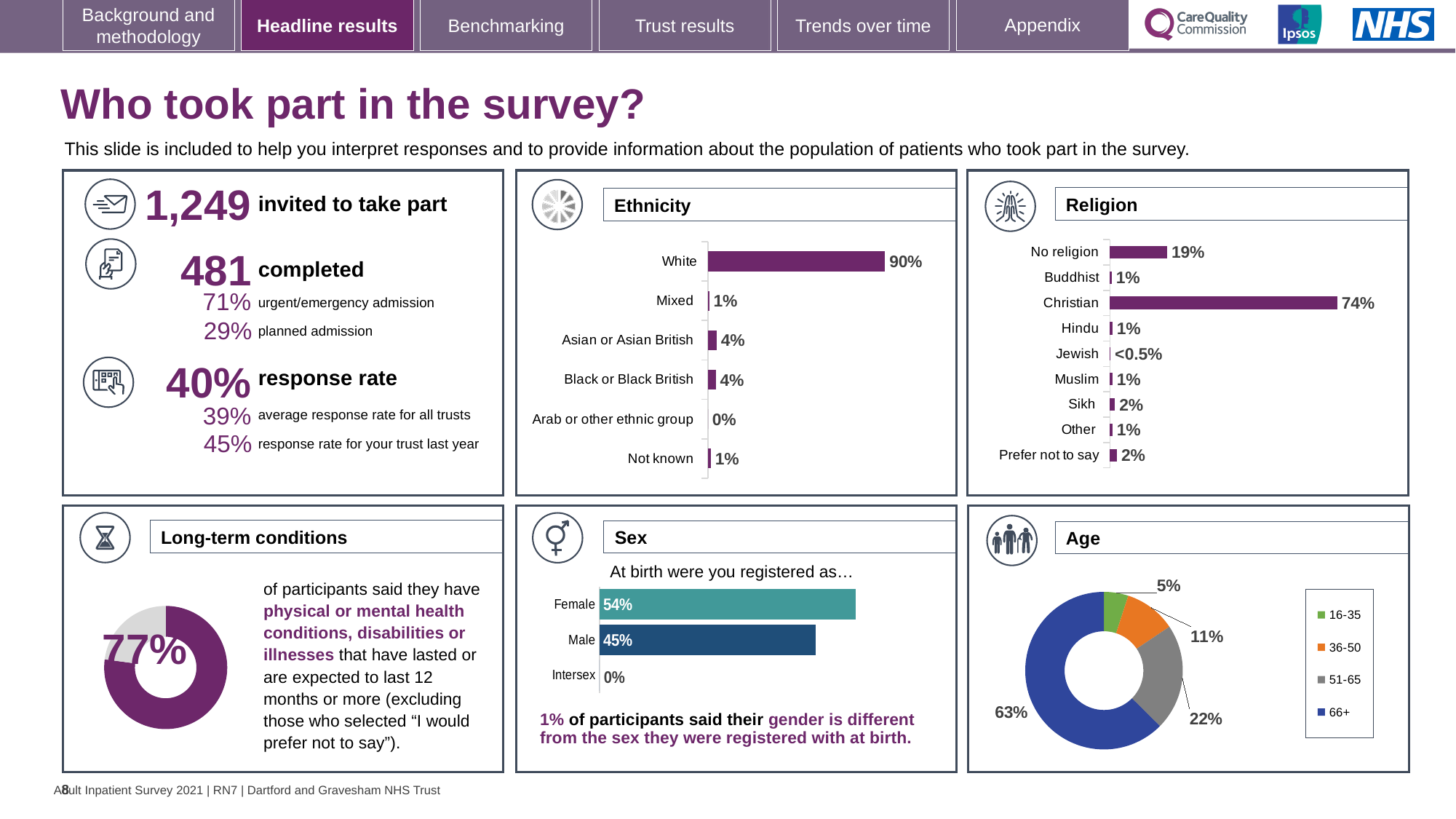
In the Religion chart, what is the value shown for Jewish? <0.5% In the Religion chart, which is larger, No religion or Sikh? No religion In the Ethnicity chart, what is the difference between the White and Asian or Asian British values? 86% In the Ethnicity chart, how many ethnicity categories are shown? 6 In the Religion chart, what percentage of participants were Christian? 74% What kind of chart is the Age chart? Doughnut chart In the Ethnicity chart, what percentage of participants were White? 90% In the Sex chart, what is the difference between the Female and Male values? 9% In the Ethnicity chart, which category has the highest value? White In the Religion chart, how many religion categories are listed? 9 In the Age chart, what share of participants were aged 66+? 63% In the Sex chart, what percentage of participants were registered as Female at birth? 54%